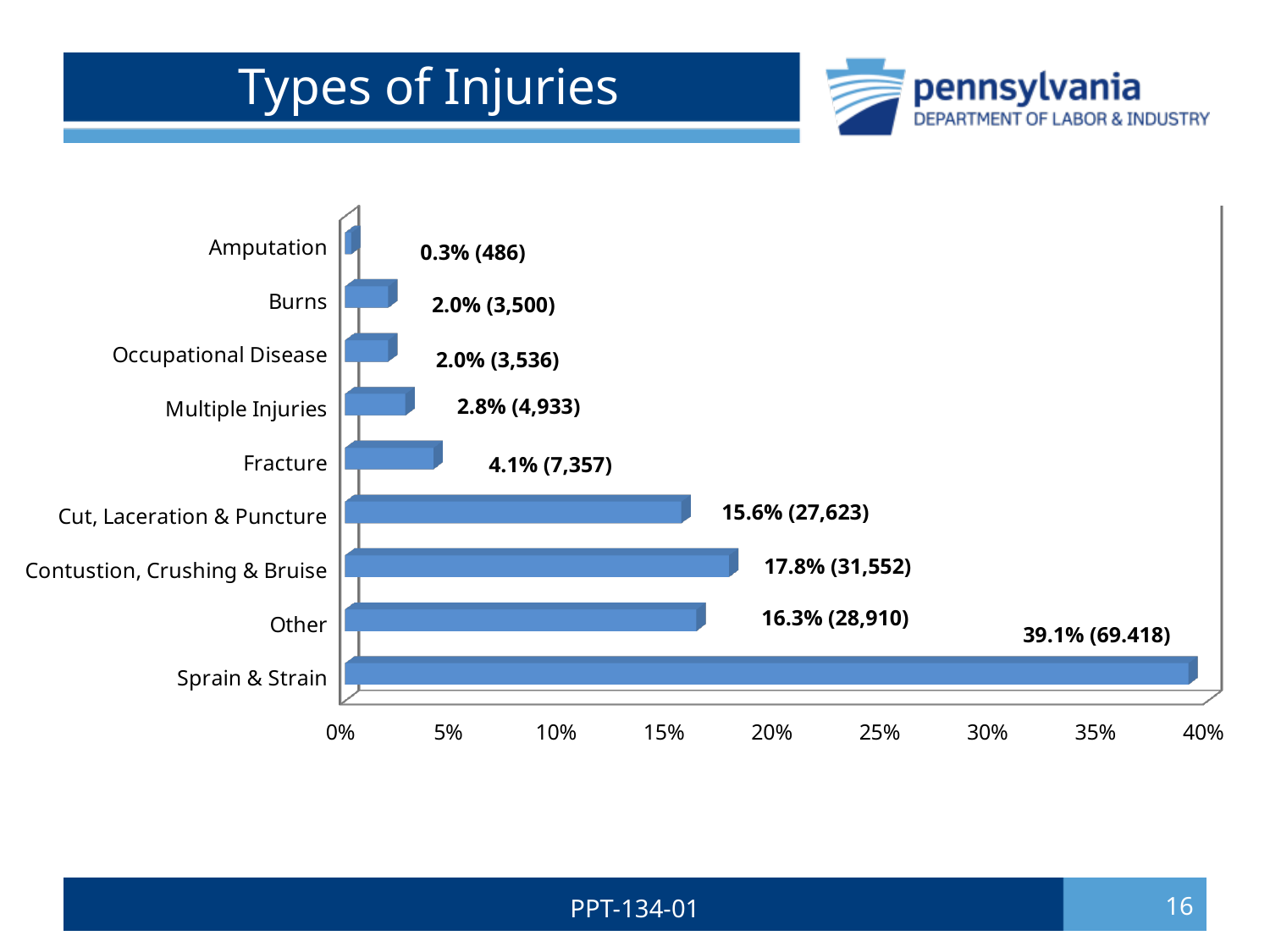
What type of chart is shown on the slide? Bar chart Which injury type has the highest percentage? Sprain & Strain What percentage is shown for Fracture? 4.1% What is the count shown in parentheses for Burns? 3,500 How many injury types are listed on the chart? 9 Is the value for Sprain & Strain greater or less than 35%? greater What percentage is shown for Multiple Injuries? 2.8% Which injury type has the lowest percentage? Amputation What is the difference in percentage points between Contustion, Crushing & Bruise and Other? 1.5 What is the title of the slide containing the chart? Types of Injuries What is the count shown in parentheses for Cut, Laceration & Puncture? 27,623 Which has a larger percentage, Other or Cut, Laceration & Puncture? Other